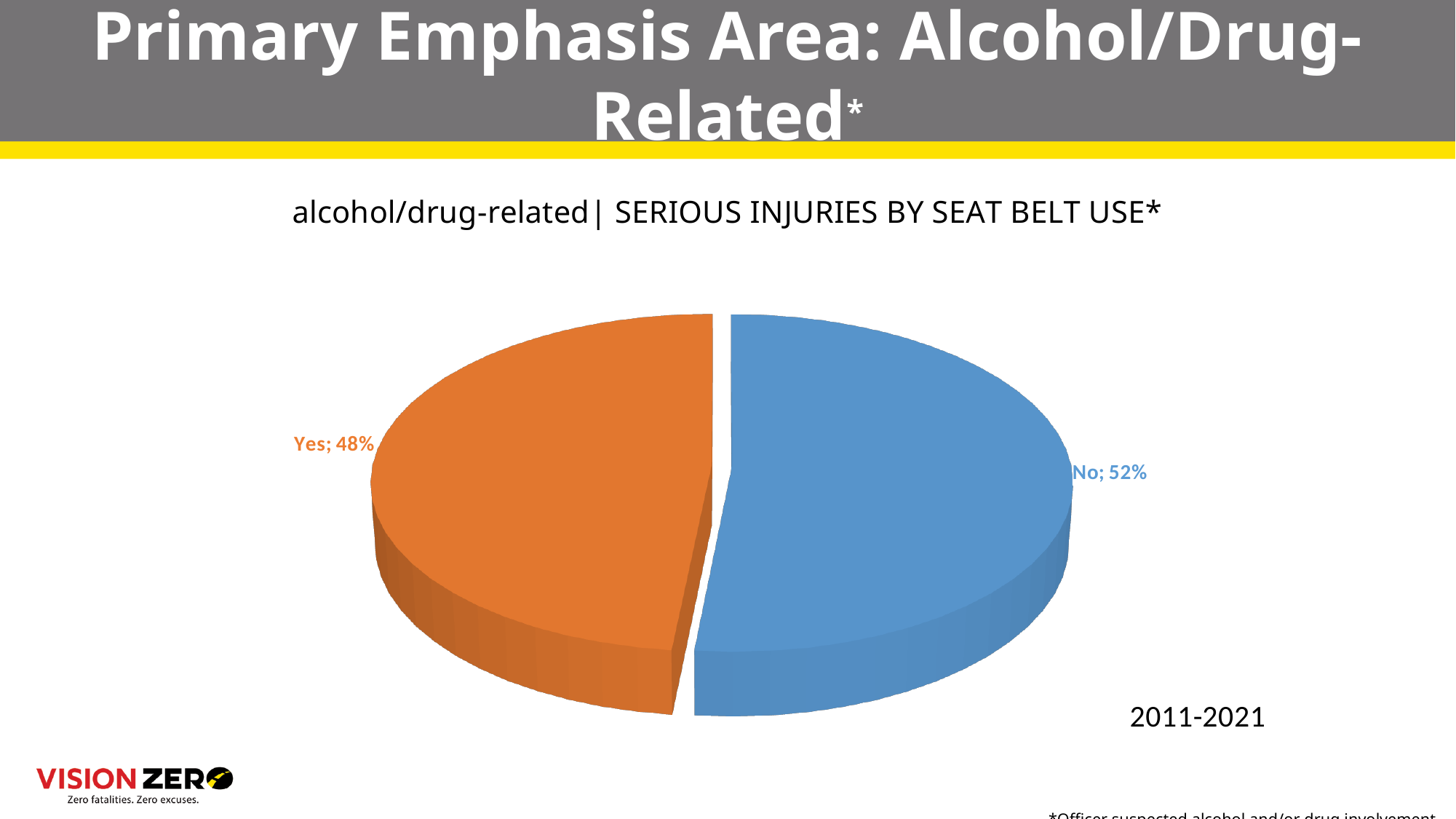
What is the difference in percentage points between the No and Yes slices? 4 What year range does the chart cover? 2011-2021 Is the share for the Yes slice greater or less than 50%? less What is the title of the chart? alcohol/drug-related| SERIOUS INJURIES BY SEAT BELT USE* What colour is the No slice of the pie? blue What kind of chart is shown on the slide? pie chart Which category has the largest share of the pie? No How many slices does the pie chart have? 2 Which category has the smallest share of the pie? Yes Which slice of the pie is larger, Yes or No? No What share of alcohol/drug-related serious injuries were for seat belt use "No"? 52% What share of alcohol/drug-related serious injuries were for seat belt use "Yes"? 48%